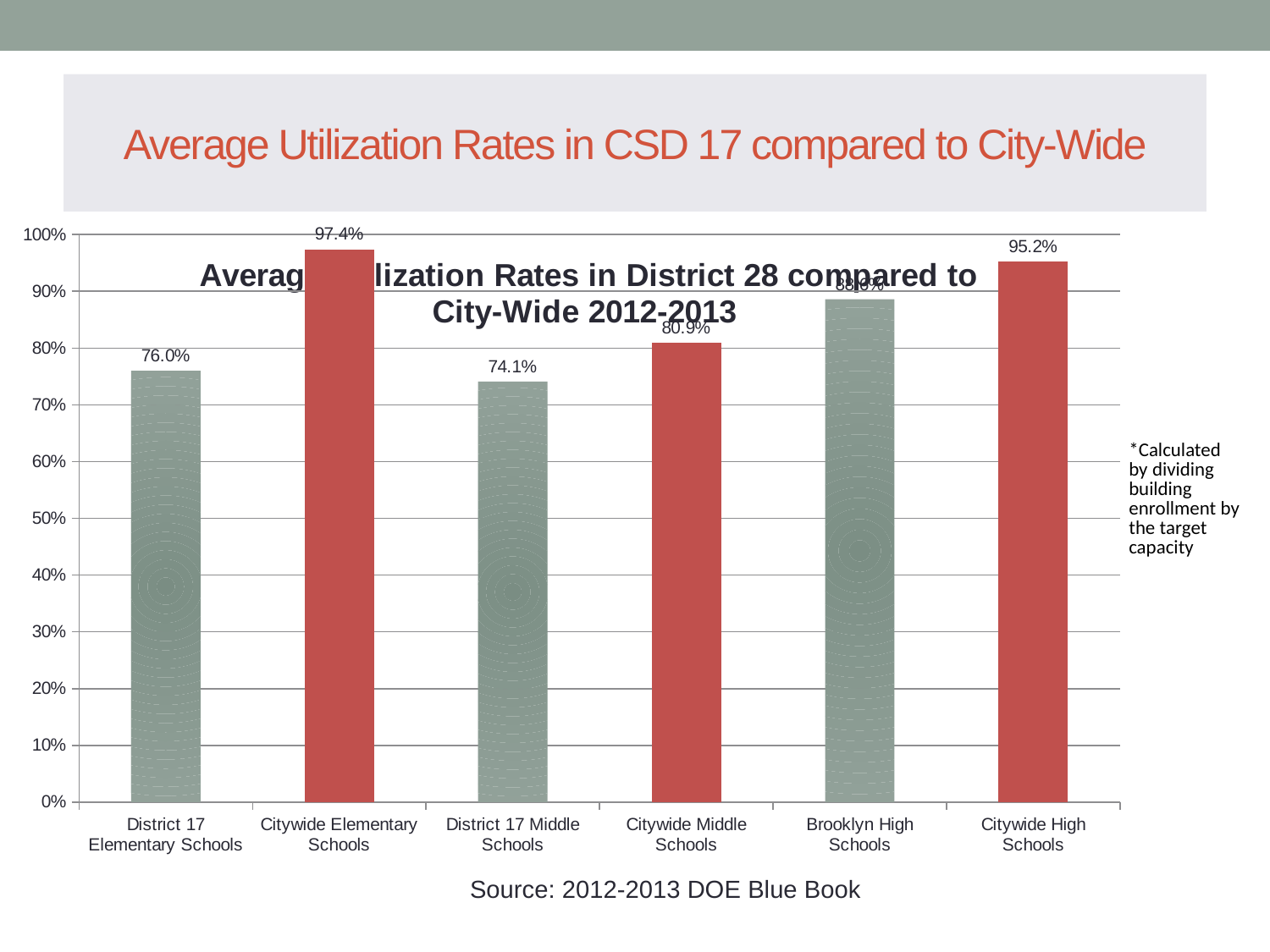
What is the average utilization rate for Citywide Elementary Schools? 97.4% What is the difference between the utilization rates of Citywide Elementary Schools and District 17 Elementary Schools? 21.4 percentage points What is the average utilization rate for District 17 Elementary Schools? 76.0% How many categories are shown on the x axis of the chart? 6 What is the average utilization rate for Citywide High Schools? 95.2% What kind of chart is shown on the slide? Bar chart What is the average utilization rate for District 17 Middle Schools? 74.1% What source is cited below the chart? 2012-2013 DOE Blue Book Which is larger, the utilization rate for Citywide Middle Schools or District 17 Middle Schools? Citywide Middle Schools Which category has the lowest utilization rate? District 17 Middle Schools Which category has the highest utilization rate? Citywide Elementary Schools Is the value for Brooklyn High Schools greater or less than 80%? greater